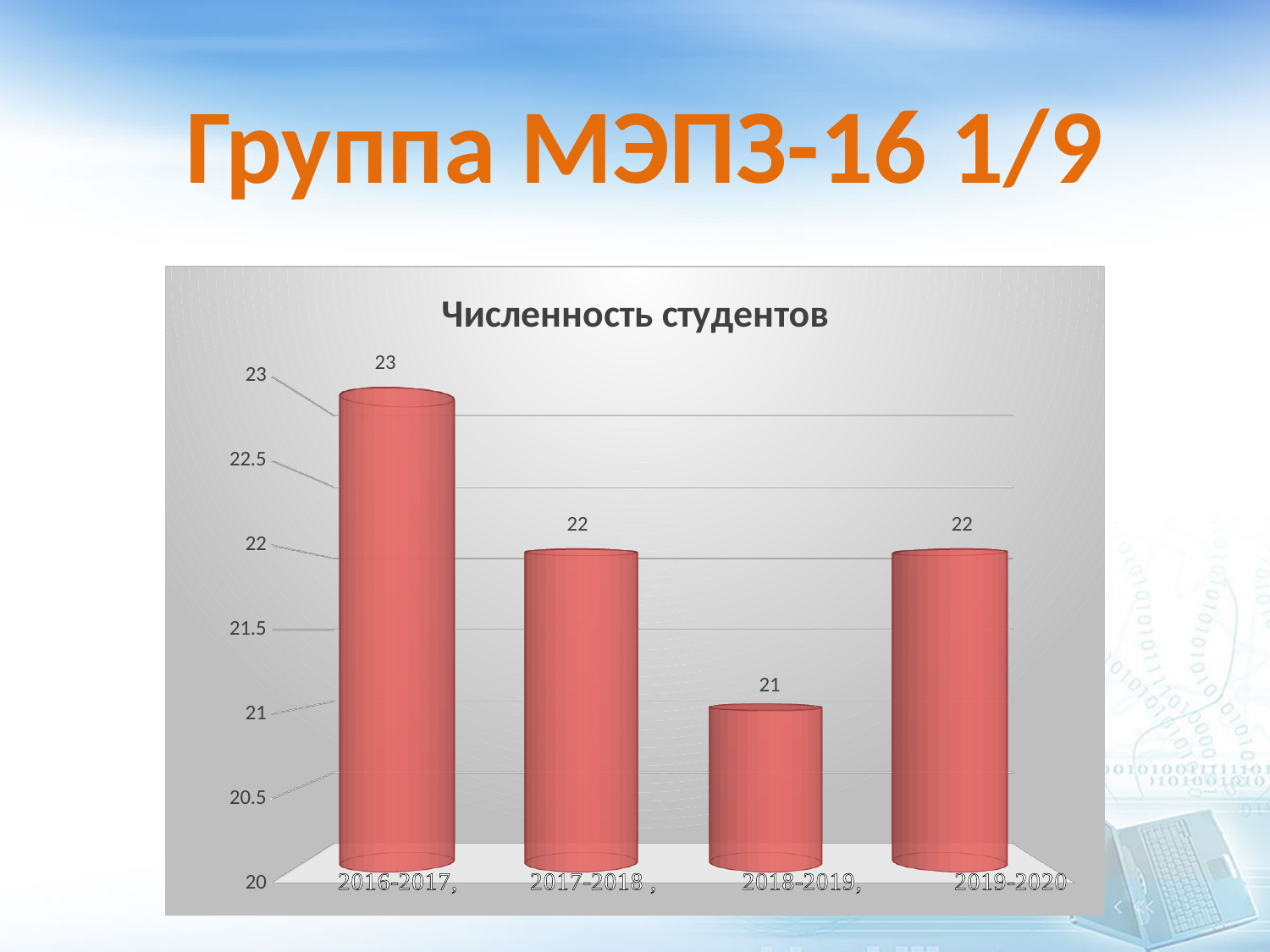
What is the difference between the values for 2016-2017 and 2018-2019? 2 Which category has the lowest value? 2018-2019 What is the title of the chart? Численность студентов What kind of chart is shown on the slide? bar chart Is the value for 2016-2017 greater or less than 22.5? greater How many categories are shown on the x axis? 4 Which is larger, the value for 2017-2018 or the value for 2018-2019? 2017-2018 Which category has the highest value? 2016-2017 What colour are the bars in the chart? red What is the value for 2018-2019 in the chart? 21 What is the value for 2019-2020 in the chart? 22 What is the value for 2016-2017 in the chart? 23